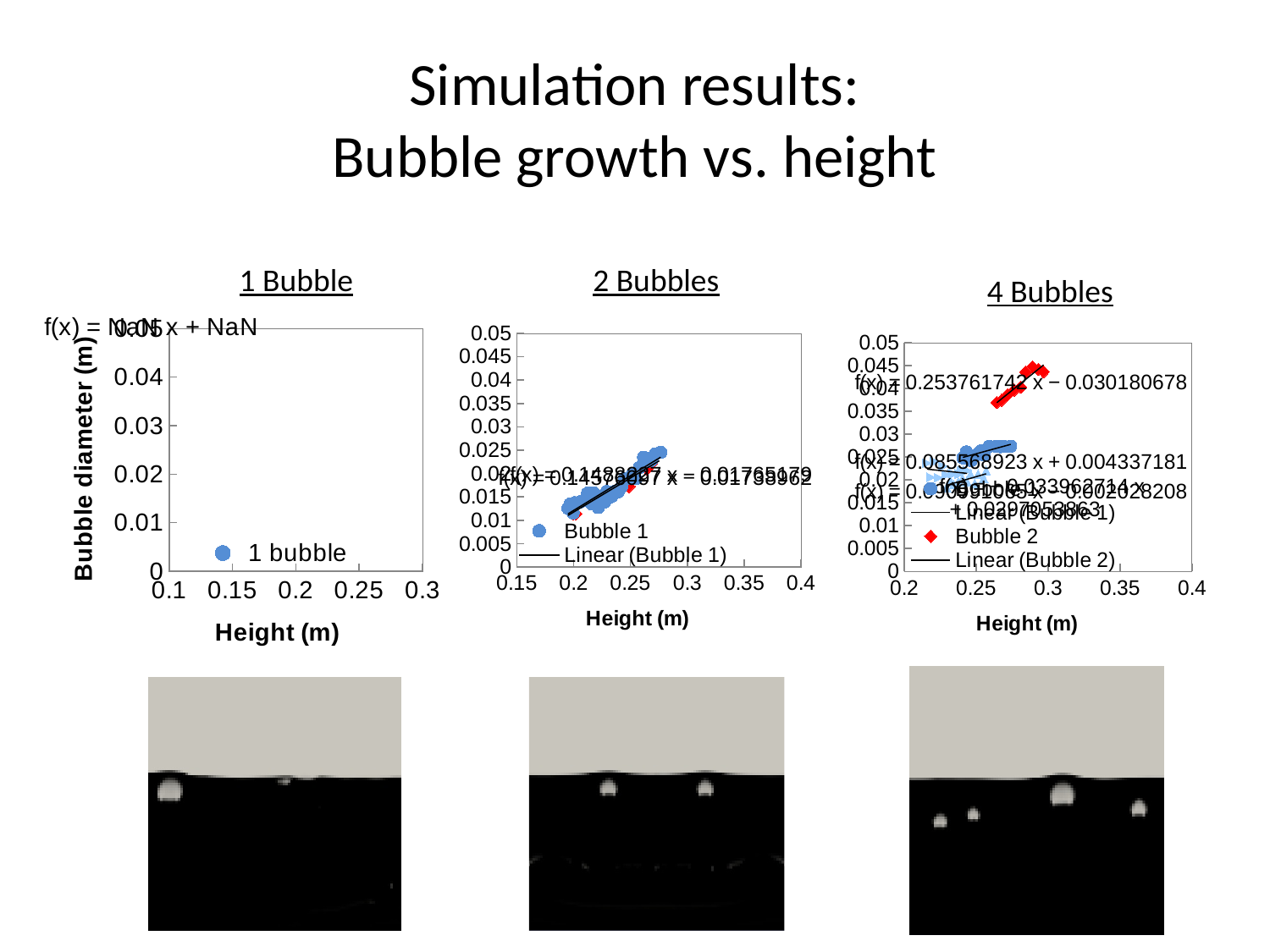
What kind of chart is the "2 Bubbles" chart? scatter chart In the "4 Bubbles" chart, do the Bubble 2 values rise or fall as height increases? rise How many entries does the legend of the "4 Bubbles" chart list? 4 What trendline equation is shown at the top of the "1 Bubble" chart? f(x) = NaN x + NaN In the "4 Bubbles" chart, are the Bubble 2 diameter values greater or less than 0.03? greater In the "4 Bubbles" chart, which series has the larger bubble diameters, Bubble 1 or Bubble 2? Bubble 2 What is the y-axis title of the "1 Bubble" chart? Bubble diameter (m) In the "2 Bubbles" chart, does bubble diameter rise or fall as height increases? rise In the "4 Bubbles" chart, are the Bubble 1 diameter values greater or less than 0.03? less In the "2 Bubbles" chart, is the largest bubble diameter plotted greater or less than 0.03? less How many charts are shown on the slide? 3